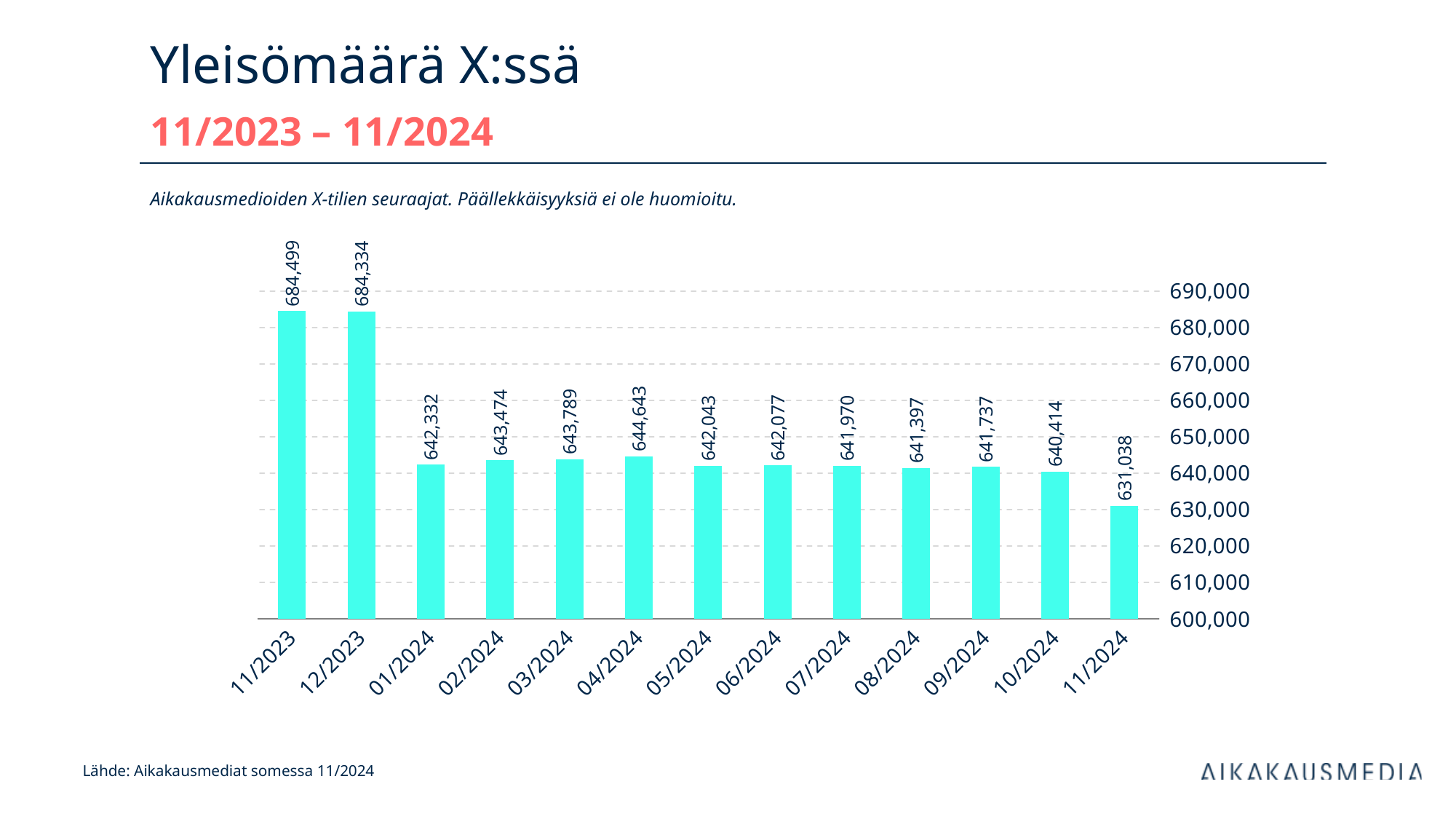
What kind of chart is shown on the slide? bar chart What is the difference between the values for 10/2024 and 11/2024? 9,376 Which month has the highest value? 11/2023 Is the value for 11/2024 greater or less than 640,000? less Do the values generally rise or fall from 11/2023 to 11/2024? fall How many months are shown on the x axis? 13 What is the difference between the values for 11/2023 and 11/2024? 53,461 Which month has the lowest value? 11/2024 What is the value for 04/2024? 644,643 Which is larger, the value for 01/2024 or the value for 02/2024? 02/2024 What is the value for 11/2024? 631,038 What is the value for 11/2023? 684,499